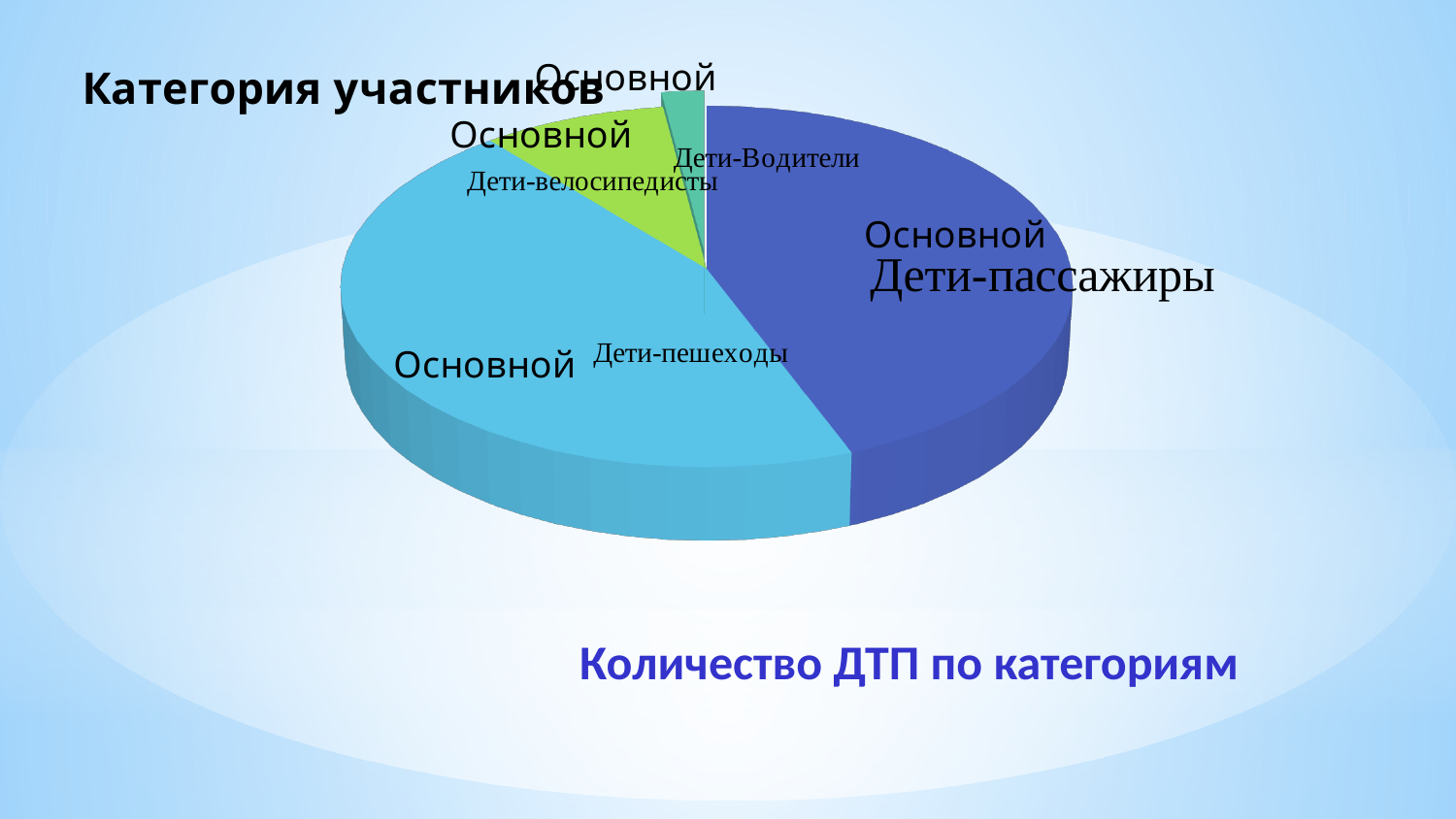
How many categories (slices) does the pie chart have? 4 Which slice is larger: Дети-пешеходы or Дети-велосипедисты? Дети-пешеходы Which category has the smallest slice in the pie chart? Дети-Водители What kind of chart is shown on the slide? pie chart Which slice is larger: Дети-велосипедисты or Дети-Водители? Дети-велосипедисты What is the title shown at the top left of the chart? Категория участников Which slice is larger: Дети-пешеходы or Дети-Водители? Дети-пешеходы What colour is the Дети-пассажиры slice? dark blue